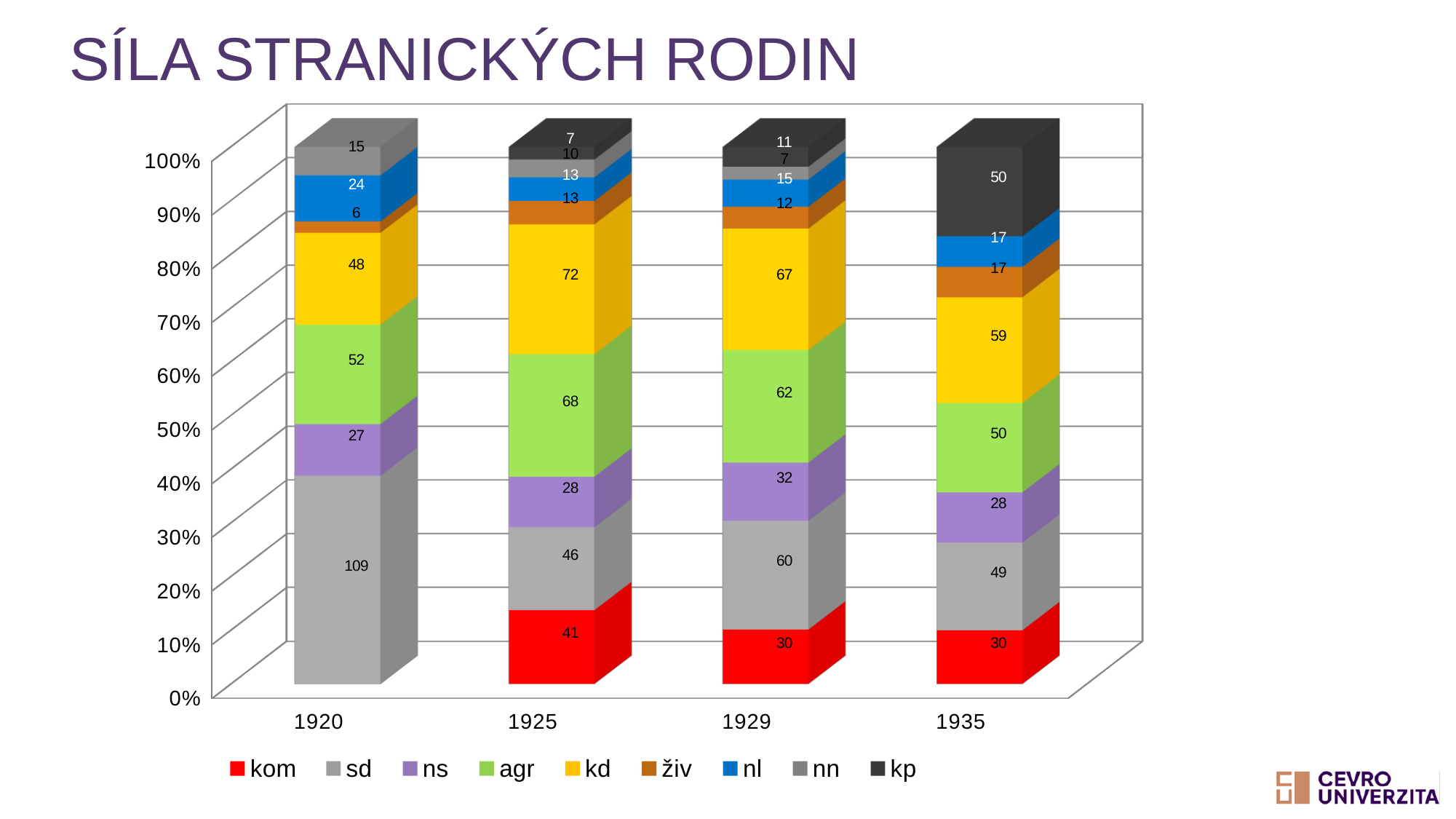
Which series has the smallest value in the 1925 bar? kp What kind of chart is shown on the slide? Stacked bar chart What is the value of the sd series for 1920? 109 What is the value of the kd series for 1925? 72 How many series does the legend list? 9 Which series has the largest value in the 1920 bar? sd What is the value of the agr series for 1929? 62 What is the difference between the kd value for 1925 and the kd value for 1935? 13 How many years are shown on the x axis? 4 Which is larger, the sd value for 1929 or the sd value for 1935? sd for 1929 What is the value of the kp series for 1935? 50 Does the kp value rise or fall from 1925 to 1935? Rises